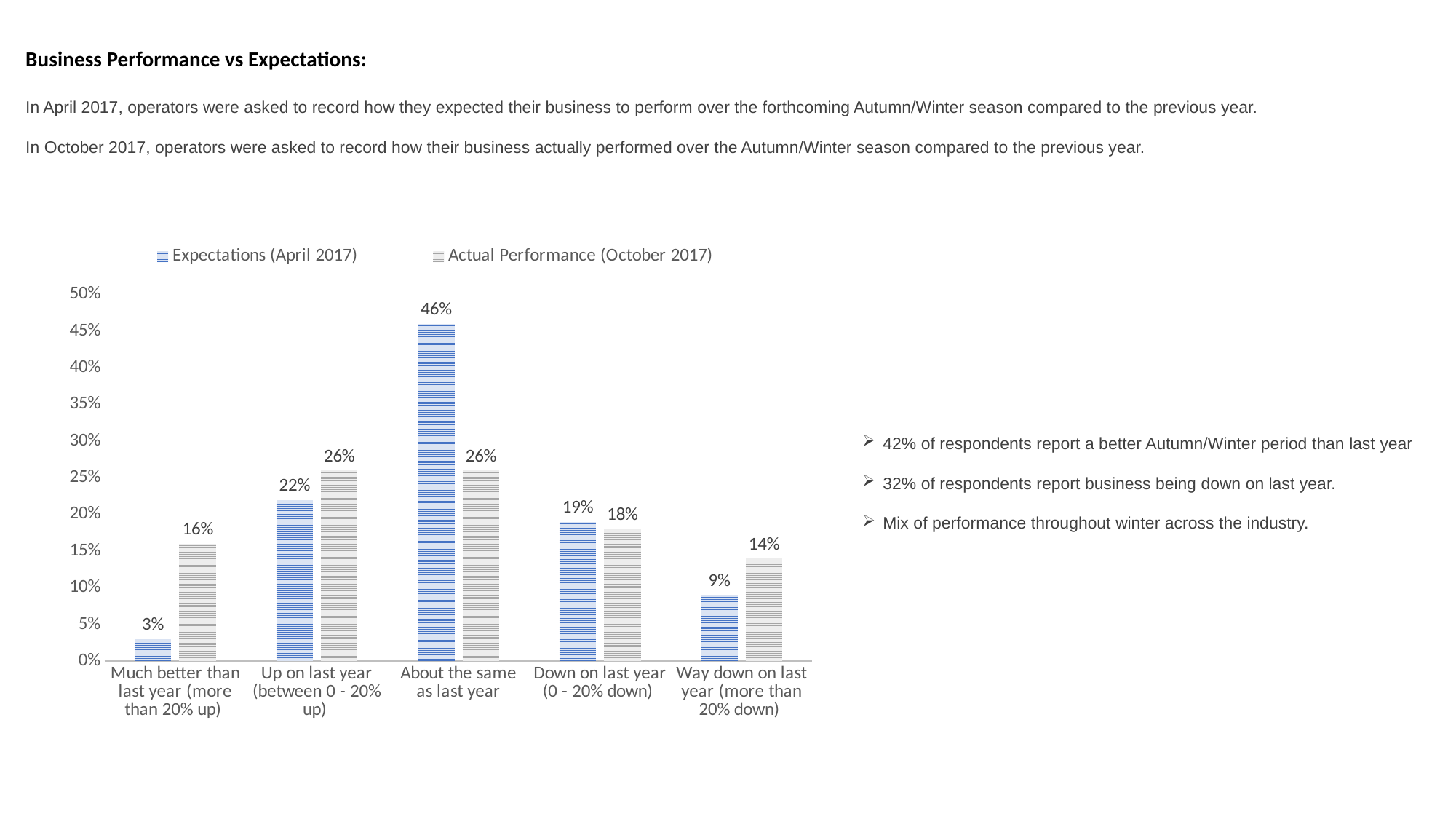
For 'Down on last year (0 - 20% down)', which is larger: Expectations (April 2017) or Actual Performance (October 2017)? Expectations (April 2017) How many series does the chart legend list? 2 Which category has the highest Expectations (April 2017) value? About the same as last year What is the Expectations (April 2017) value for 'About the same as last year'? 46% What is the difference between the Actual Performance (October 2017) and Expectations (April 2017) values for 'Much better than last year (more than 20% up)'? 13% What is the Expectations (April 2017) value for 'Way down on last year (more than 20% down)'? 9% Which category has the lowest Expectations (April 2017) value? Much better than last year (more than 20% up) What is the difference between the Expectations (April 2017) and Actual Performance (October 2017) values for 'About the same as last year'? 20% Is the Expectations (April 2017) value for 'Up on last year (between 0 - 20% up)' greater or less than 20%? greater What kind of chart is shown on the slide? Bar chart What is the Actual Performance (October 2017) value for 'Much better than last year (more than 20% up)'? 16% How many categories are shown on the x axis of the chart? 5